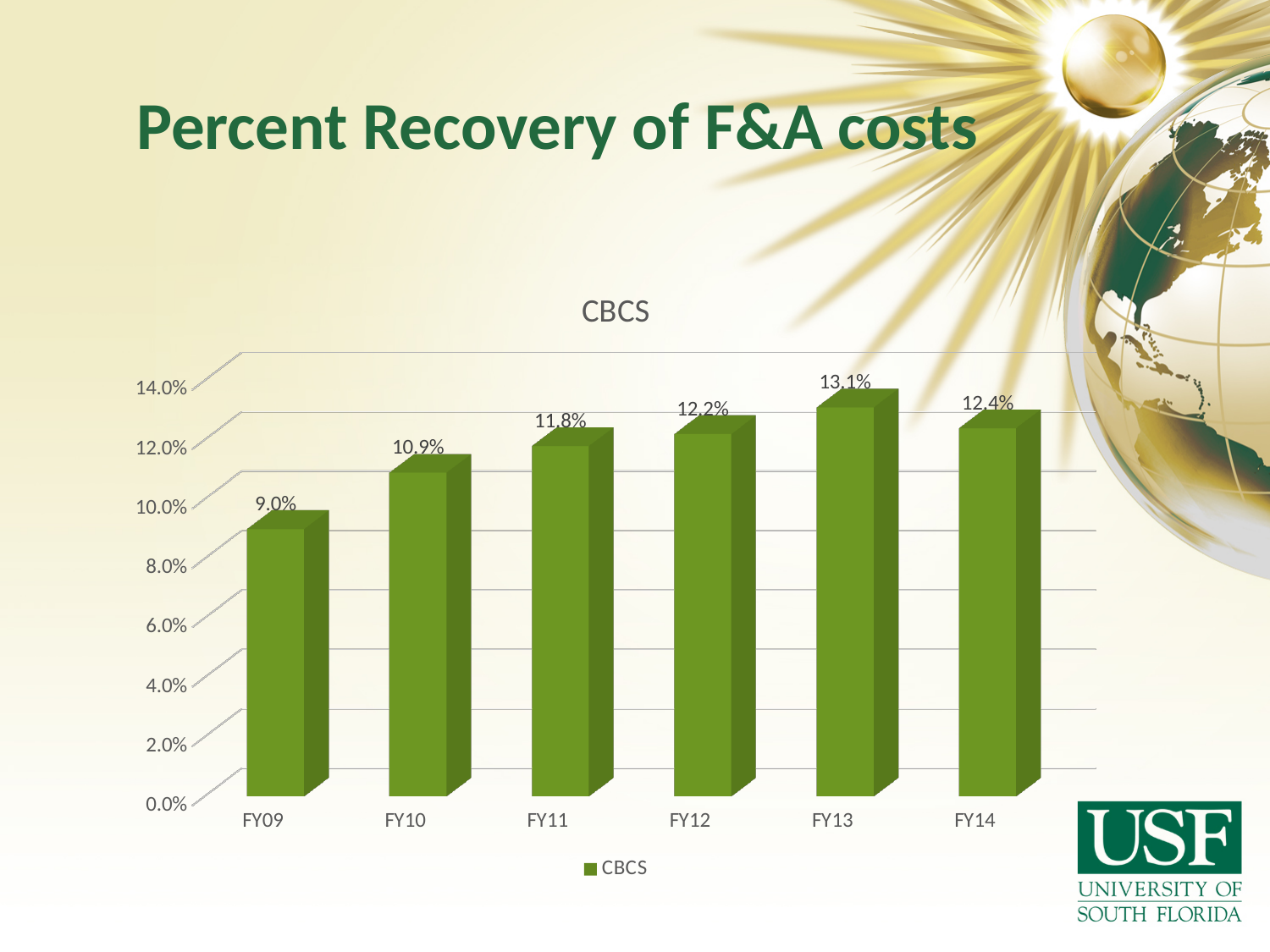
How many fiscal years are shown on the x axis? 6 What is the difference between the values for FY13 and FY09? 4.1% What kind of chart is shown on the slide? bar chart Which fiscal year has the lowest value? FY09 Which is larger, the value for FY10 or the value for FY12? FY12 What is the value for FY12? 12.2% What is the value for FY14? 12.4% What is the difference between the values for FY11 and FY10? 0.9% Which fiscal year has the highest value? FY13 Is the value for FY11 greater or less than 10.0%? greater What is the title of the chart? CBCS What is the value for FY09? 9.0%